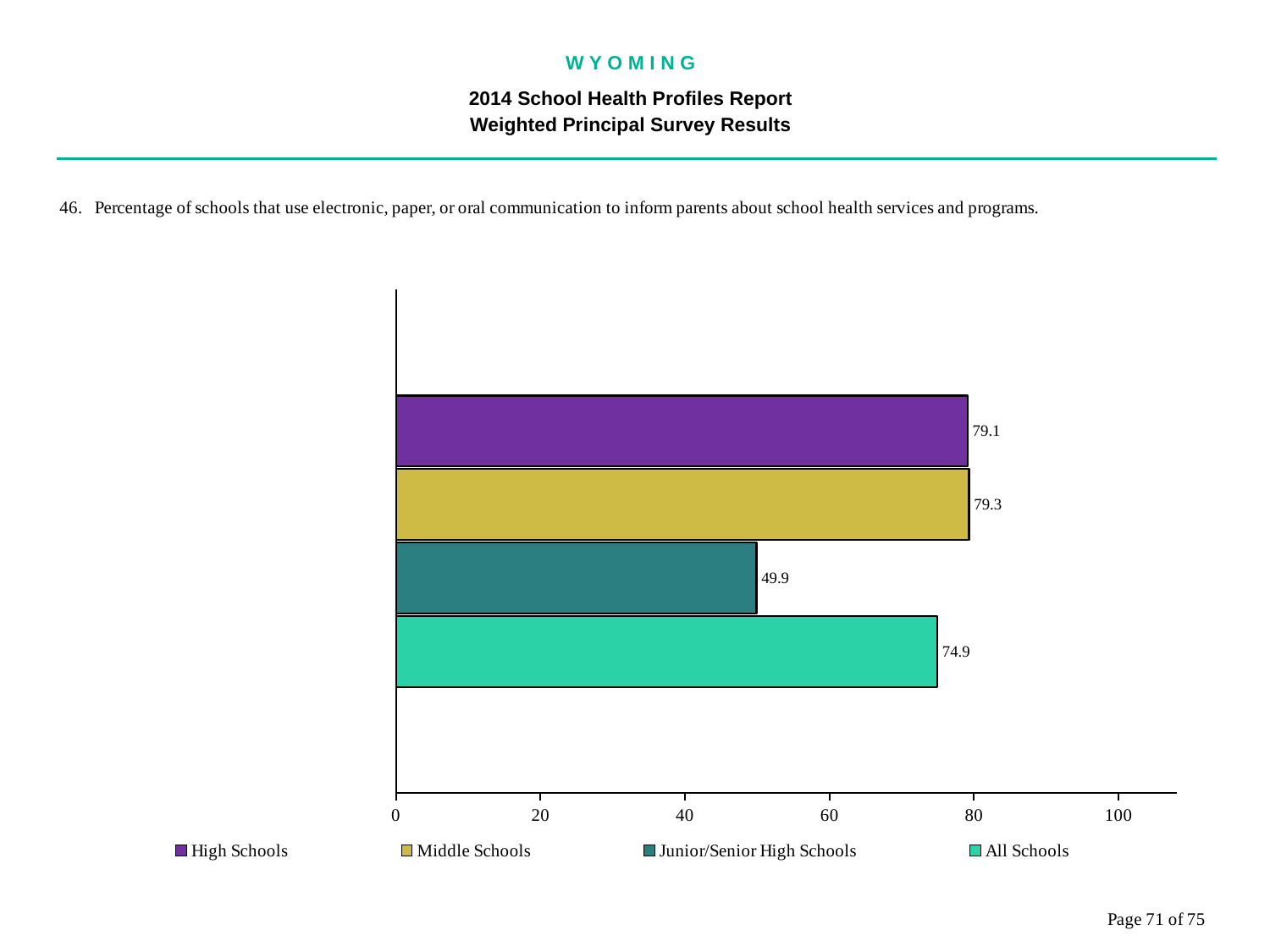
How many bars are shown in the chart? 4 What is the value for High Schools? 79.1 Which is larger, the value for High Schools or the value for Junior/Senior High Schools? High Schools What is the value for Middle Schools? 79.3 What is the difference between the values for High Schools and All Schools? 4.2 What is the value for All Schools? 74.9 How many entries does the legend list? 4 What is the value for Junior/Senior High Schools? 49.9 What kind of chart is shown on the slide? bar chart Is the value for All Schools greater or less than 60? greater Which category has the lowest value? Junior/Senior High Schools What is the difference between the values for Middle Schools and Junior/Senior High Schools? 29.4